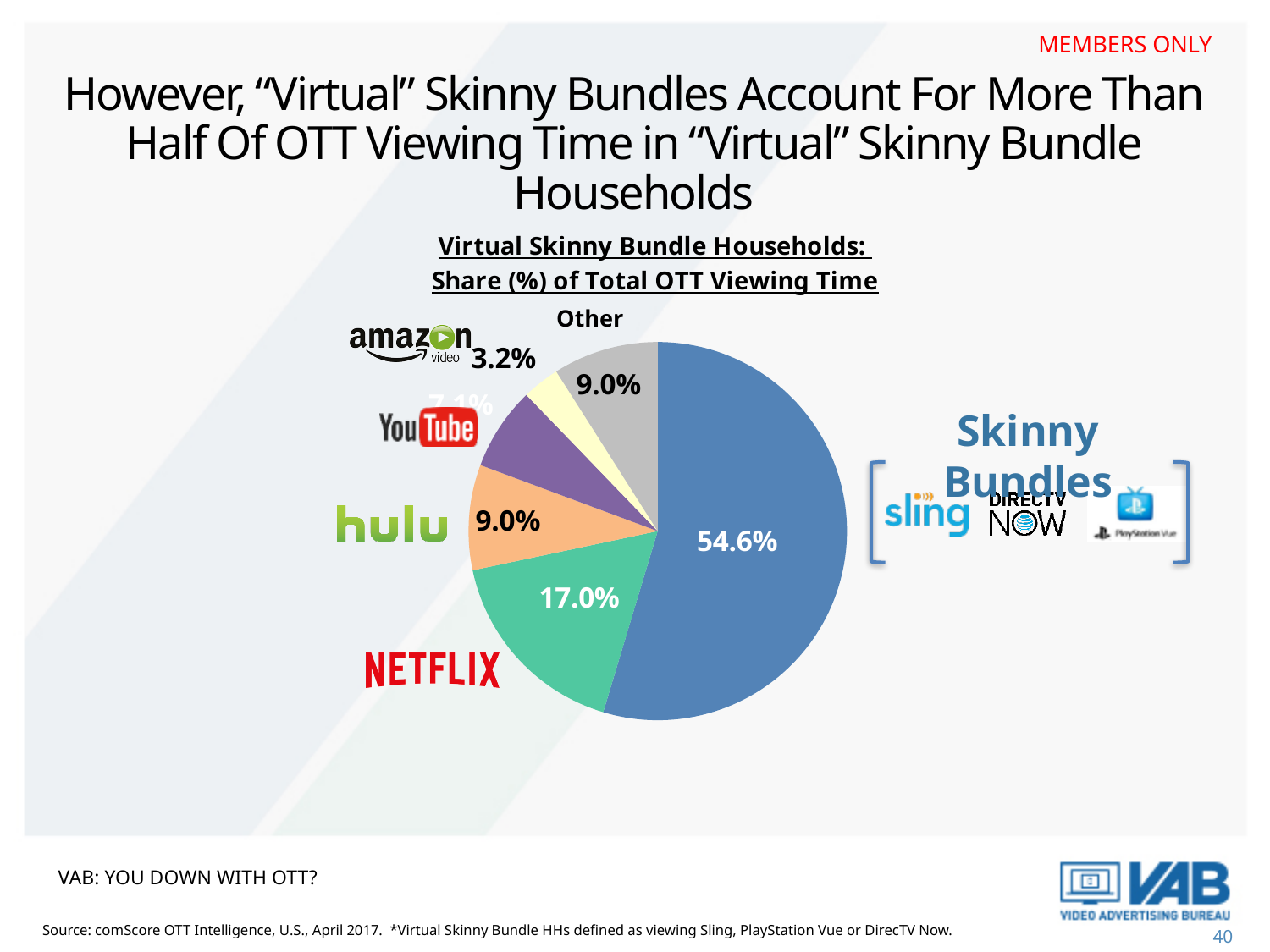
Which slice of the pie chart is the largest? Skinny Bundles What share of total OTT viewing time do Skinny Bundles account for? 54.6% What kind of chart is shown on the slide? Pie chart How many percentage points larger is the Skinny Bundles share than the Netflix share? 37.6 percentage points What is the title of the pie chart? Virtual Skinny Bundle Households: Share (%) of Total OTT Viewing Time How many slices does the pie chart have? 6 What share of total OTT viewing time does the Other slice account for? 9.0% What share of total OTT viewing time does Amazon Video account for? 3.2% Which has a larger share of OTT viewing time, Netflix or Hulu? Netflix What share of total OTT viewing time does Hulu account for? 9.0% Which slice of the pie chart is the smallest? Amazon Video What share of total OTT viewing time does Netflix account for? 17.0%